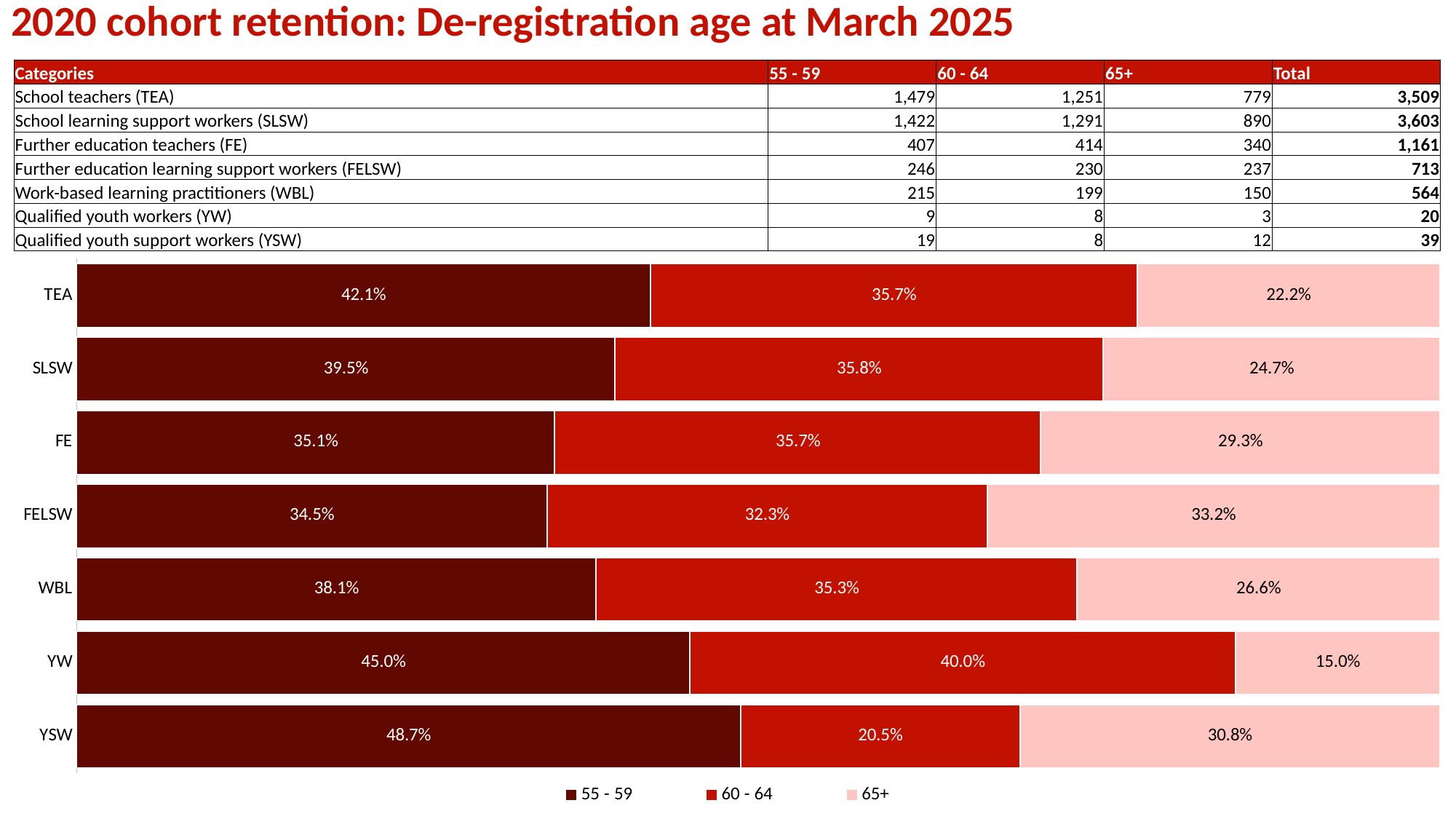
In the stacked bar chart, which category has the highest 55 - 59 share? YSW What kind of chart is shown below the table? Stacked bar chart In the stacked bar chart, what percentage of the FELSW category is in the 65+ age group? 33.2% In the stacked bar chart, which category has the highest 60 - 64 share? YW In the stacked bar chart, what is the difference in percentage points between the 60 - 64 share for YW and for YSW? 19.5 percentage points How many series does the legend of the stacked bar chart list? 3 In the stacked bar chart, which has the larger 65+ share, FE or SLSW? FE In the stacked bar chart, which category has the lowest 55 - 59 share? FELSW In the stacked bar chart, which category has the lowest 65+ share? YW In the stacked bar chart, what percentage of the WBL category is in the 60 - 64 age group? 35.3% How many categories are shown in the stacked bar chart? 7 In the stacked bar chart, what percentage of the TEA category is in the 55 - 59 age group? 42.1%